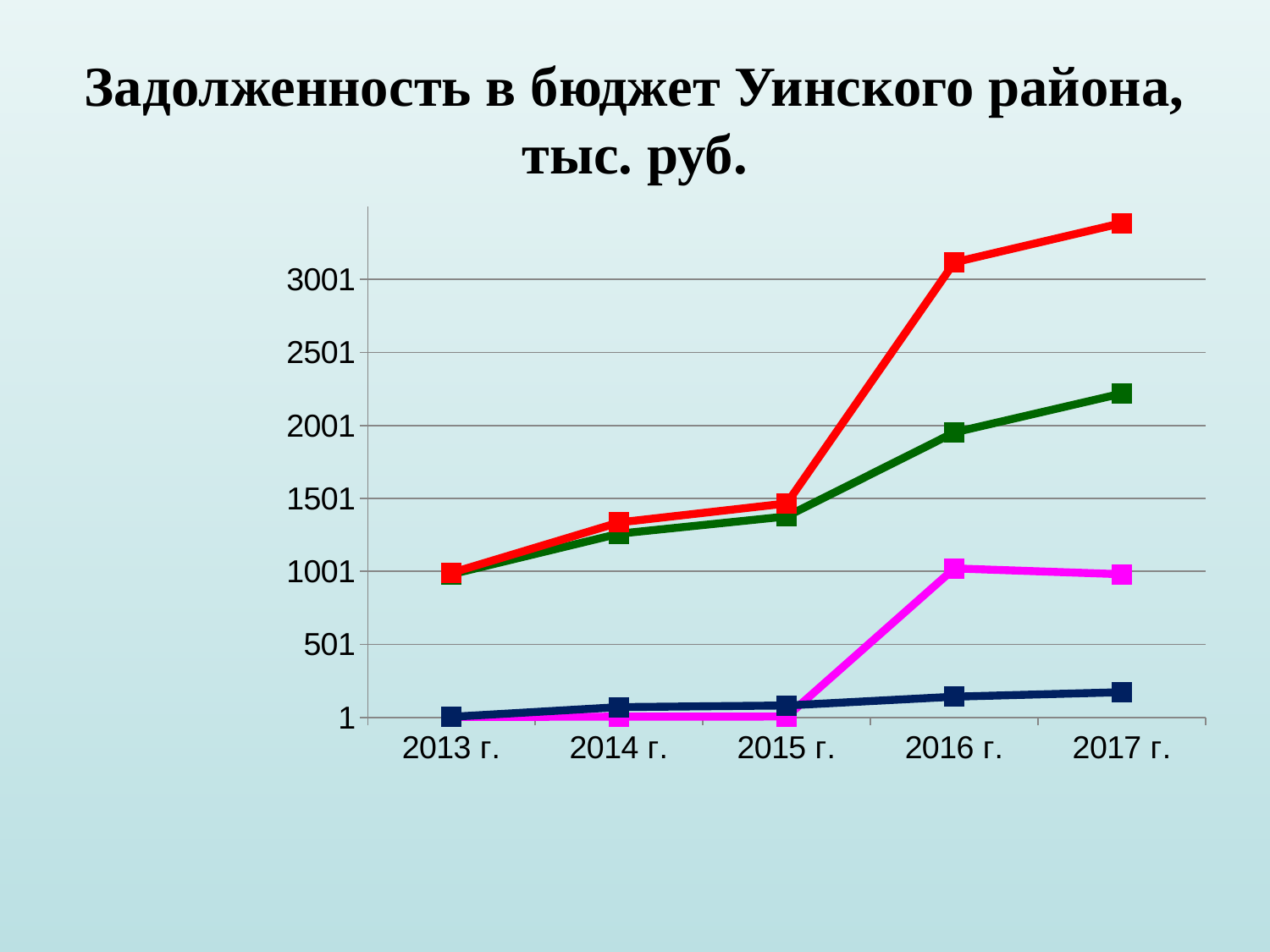
Is the value of the green line in 2017 г. greater or less than 2501? less In 2016 г., which is larger: the magenta line or the dark blue line? the magenta line Is the value of the dark blue line in 2017 г. greater or less than 501? less What is the title of the chart? Задолженность в бюджет Уинского района, тыс. руб. Which line has the lowest value in 2017 г.? the dark blue line Which line has the highest value in 2017 г.? the red line How many lines are plotted on the chart? 4 Is the value of the red line in 2014 г. greater or less than 1001? greater Does the red line rise or fall from 2013 г. to 2017 г.? rises What kind of chart is shown on the slide? line chart How many years are shown along the x axis? 5